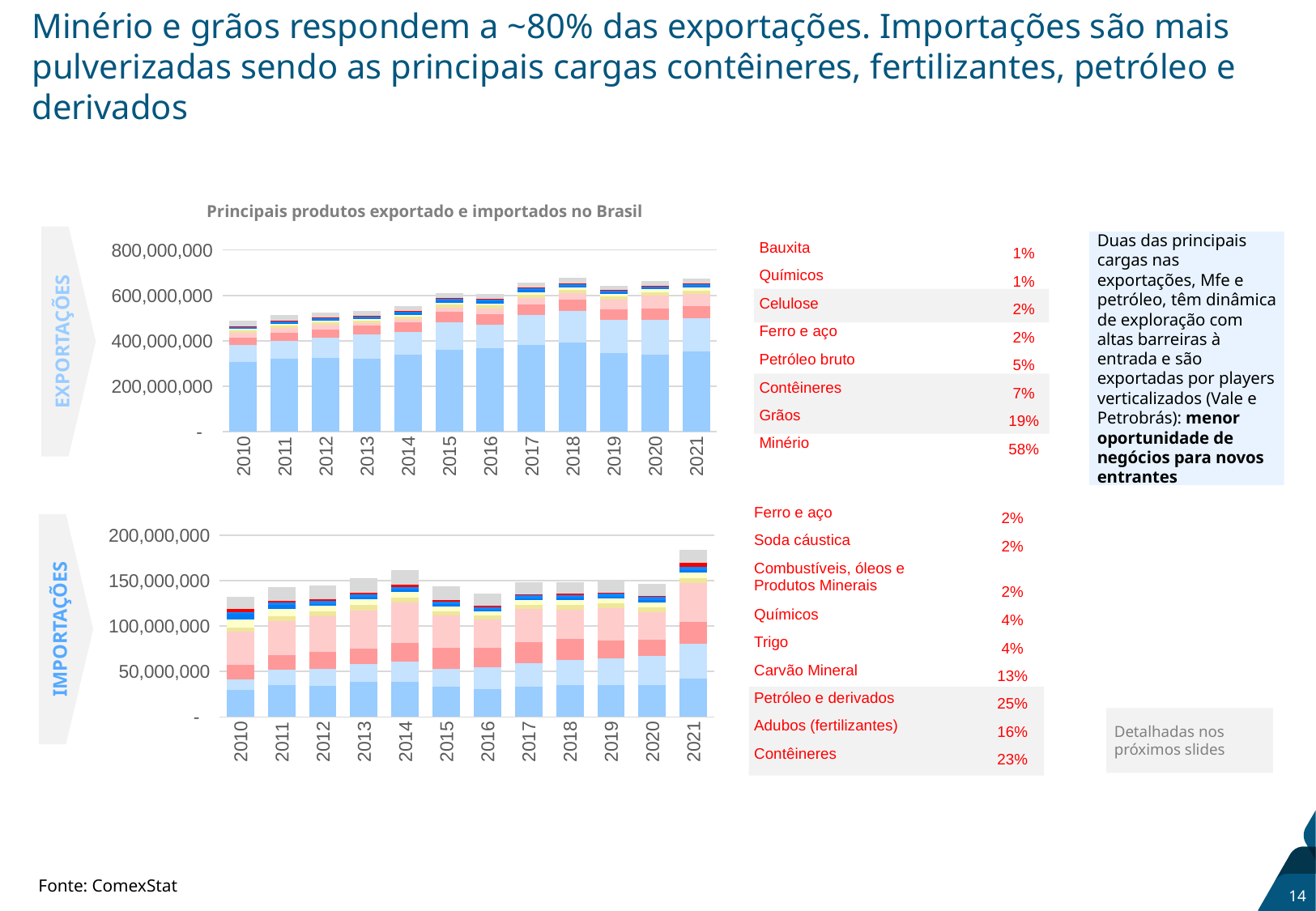
In the Exportações chart, is the total for 2018 greater or less than 600,000,000? greater In the Exportações chart, is the total for 2010 greater or less than 600,000,000? less In the Importações chart, is the total for 2016 greater or less than 150,000,000? less In the Importações chart, is the total for 2021 larger or smaller than the total for 2020? larger What is the title shown above the two charts? Principais produtos exportado e importados no Brasil What kind of chart is the Exportações chart at the top of the slide? stacked bar chart How many years are shown on the x axis of the Importações chart? 12 In the Importações chart, which year has the highest total bar? 2021 In the Exportações chart, do the total bars generally rise or fall from 2010 to 2021? rise What is the highest value shown on the y axis of the Importações chart? 200,000,000 In the Exportações chart, which year has the lowest total bar? 2010